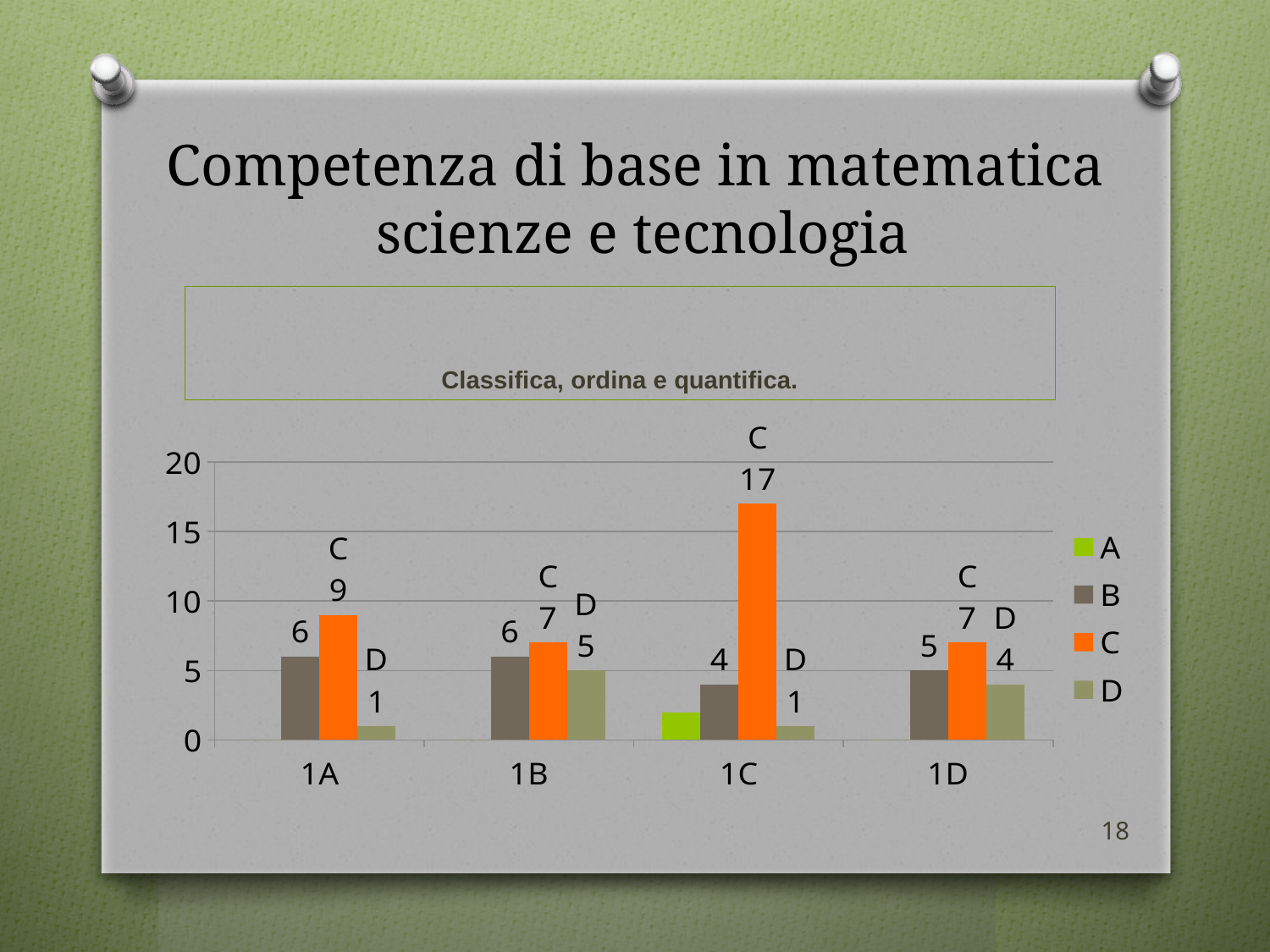
What is the difference between the series C values for class 1C and class 1A? 8 What is the value of series C for class 1C? 17 What kind of chart is shown on the slide? Bar chart Which class has the lowest value for series B? 1C What is the value of series D for class 1B? 5 What is the value of series B for class 1A? 6 Which class has the highest value for series C? 1C How many classes are shown on the x axis? 4 Which is larger: series D for class 1B or series D for class 1D? Series D for class 1B Is the value of series A for class 1C greater or less than 5? less What is the value of series C for class 1D? 7 How many series does the legend list? 4